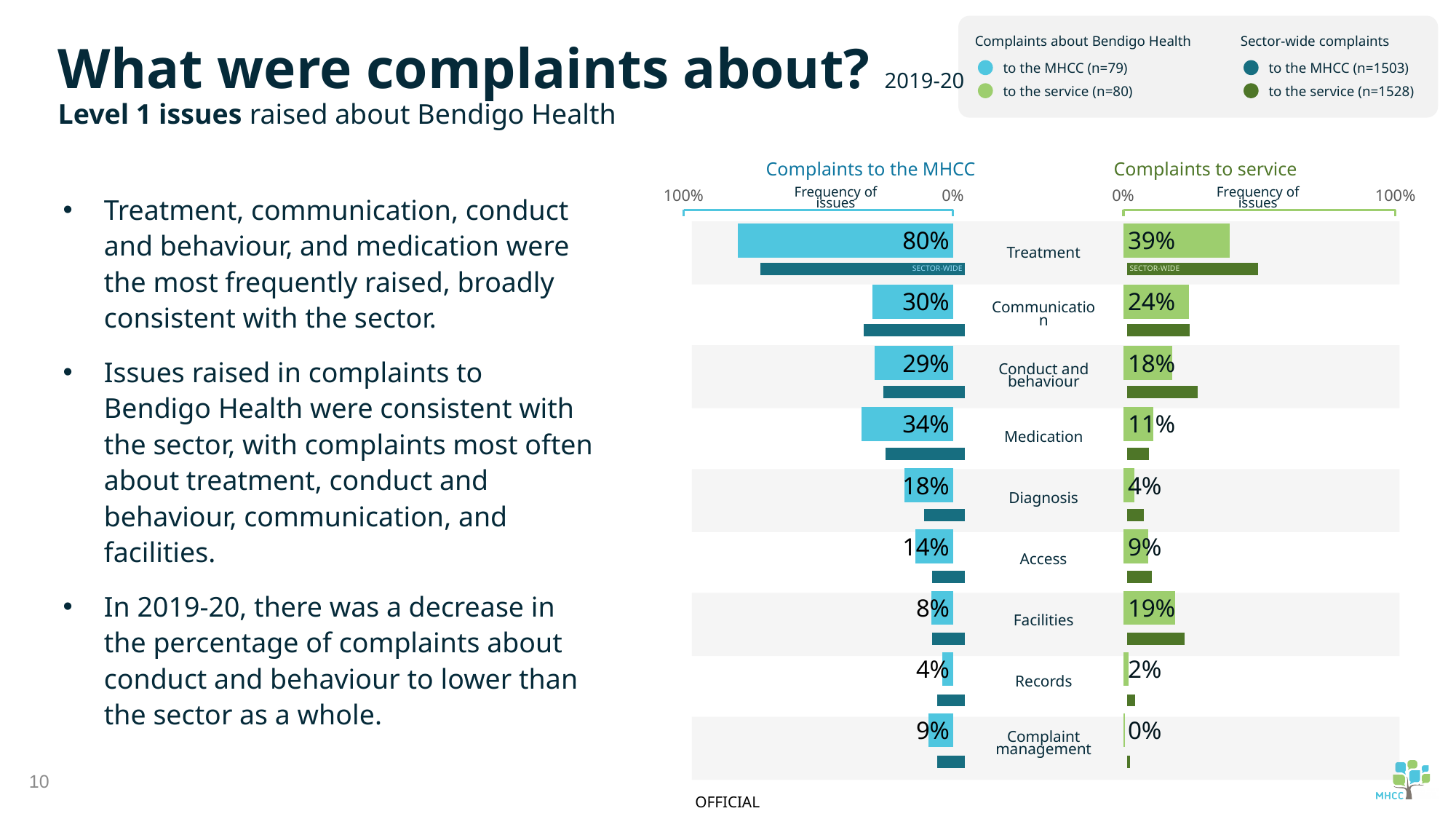
In the 'Complaints to service' chart, what percentage of issues were about Facilities? 19% In the 'Complaints to the MHCC' chart, what is the difference between the values for Treatment and Communication? 50% In the 'Complaints to the MHCC' chart, which is larger: the value for Medication or the value for Communication? Medication In the 'Complaints to service' chart, which category has the highest frequency of issues? Treatment In the 'Complaints to service' chart, which category has the lowest frequency of issues? Complaint management In the 'Complaints to the MHCC' chart, what is the value for Medication? 34% In the 'Complaints to service' chart, what is the difference between the values for Communication and Conduct and behaviour? 6% How many categories of issues are shown in the 'Complaints to the MHCC' chart? 9 In the 'Complaints to the MHCC' chart, which category has the lowest frequency of issues? Records In the 'Complaints to the MHCC' chart, what percentage of issues were about Treatment? 80% In the 'Complaints to service' chart, which is larger: the value for Facilities or the value for Medication? Facilities What kind of chart is the 'Complaints to service' chart? Bar chart